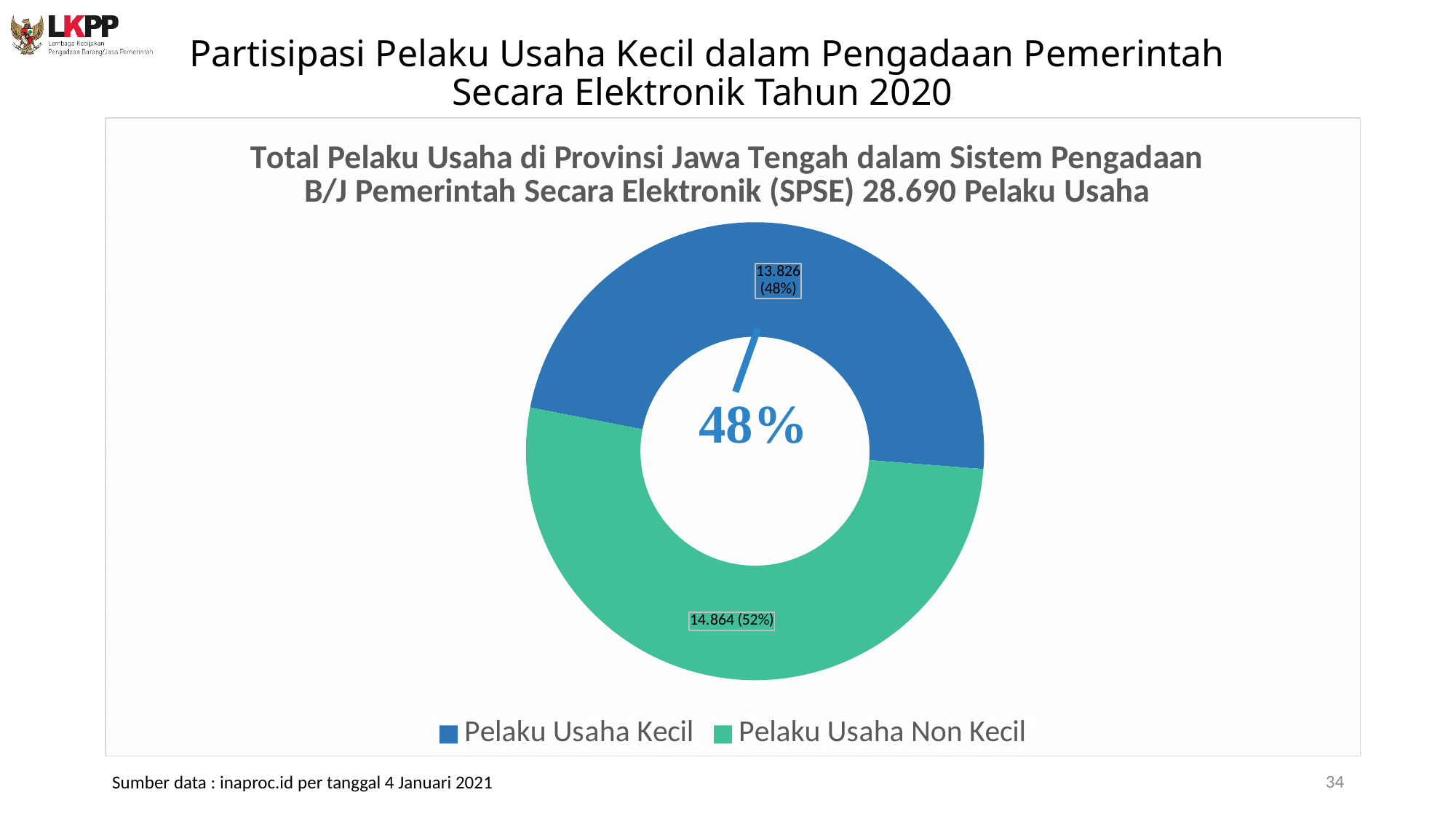
How many categories does the chart show? 2 What total number of Pelaku Usaha is stated in the chart title? 28.690 Which category has the smaller value? Pelaku Usaha Kecil What is the value for Pelaku Usaha Non Kecil? 14.864 What is the difference between the values for Pelaku Usaha Non Kecil and Pelaku Usaha Kecil? 1.038 What share of the chart does Pelaku Usaha Kecil represent? 48% Which category has the larger value? Pelaku Usaha Non Kecil Is the value for Pelaku Usaha Kecil larger or smaller than the value for Pelaku Usaha Non Kecil? Smaller What kind of chart is shown on the slide? Doughnut (pie) chart Which colour represents Pelaku Usaha Non Kecil in the legend? Green What is the value for Pelaku Usaha Kecil? 13.826 What share of the chart does Pelaku Usaha Non Kecil represent? 52%